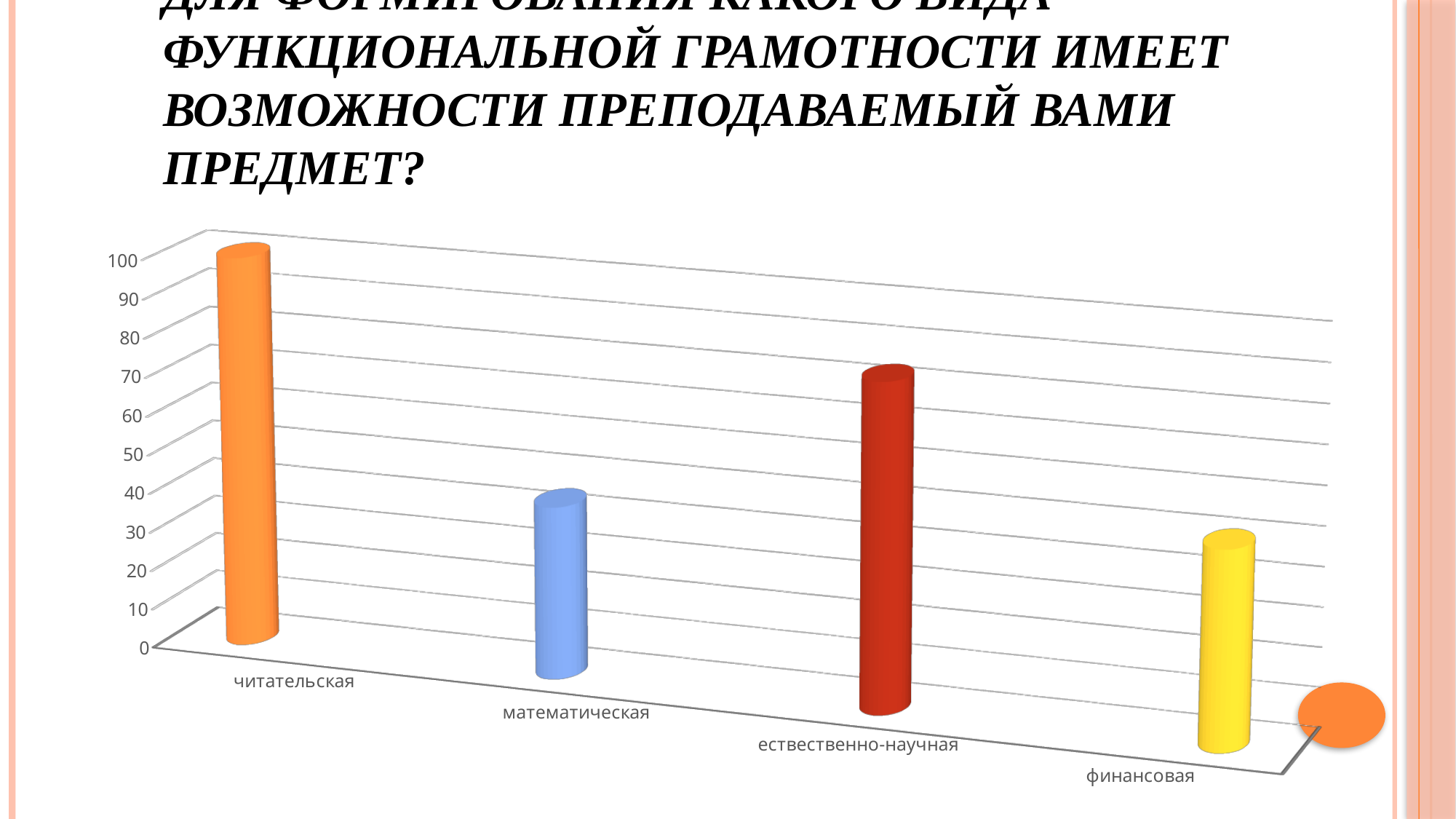
Among the labelled categories, which has the lowest bar? математическая What kind of chart is shown on the slide? bar chart Which category has the highest bar? читательская Is the value for математическая greater or less than 50? less Is the value for естественно-научная greater or less than 50? greater What is the highest value shown on the vertical axis? 100 Which is larger, the value for математическая or the value for финансовая? финансовая What colour is the bar for естественно-научная? red Is the value for читательская greater or less than 80? greater Which is larger, the value for читательская or the value for естественно-научная? читательская